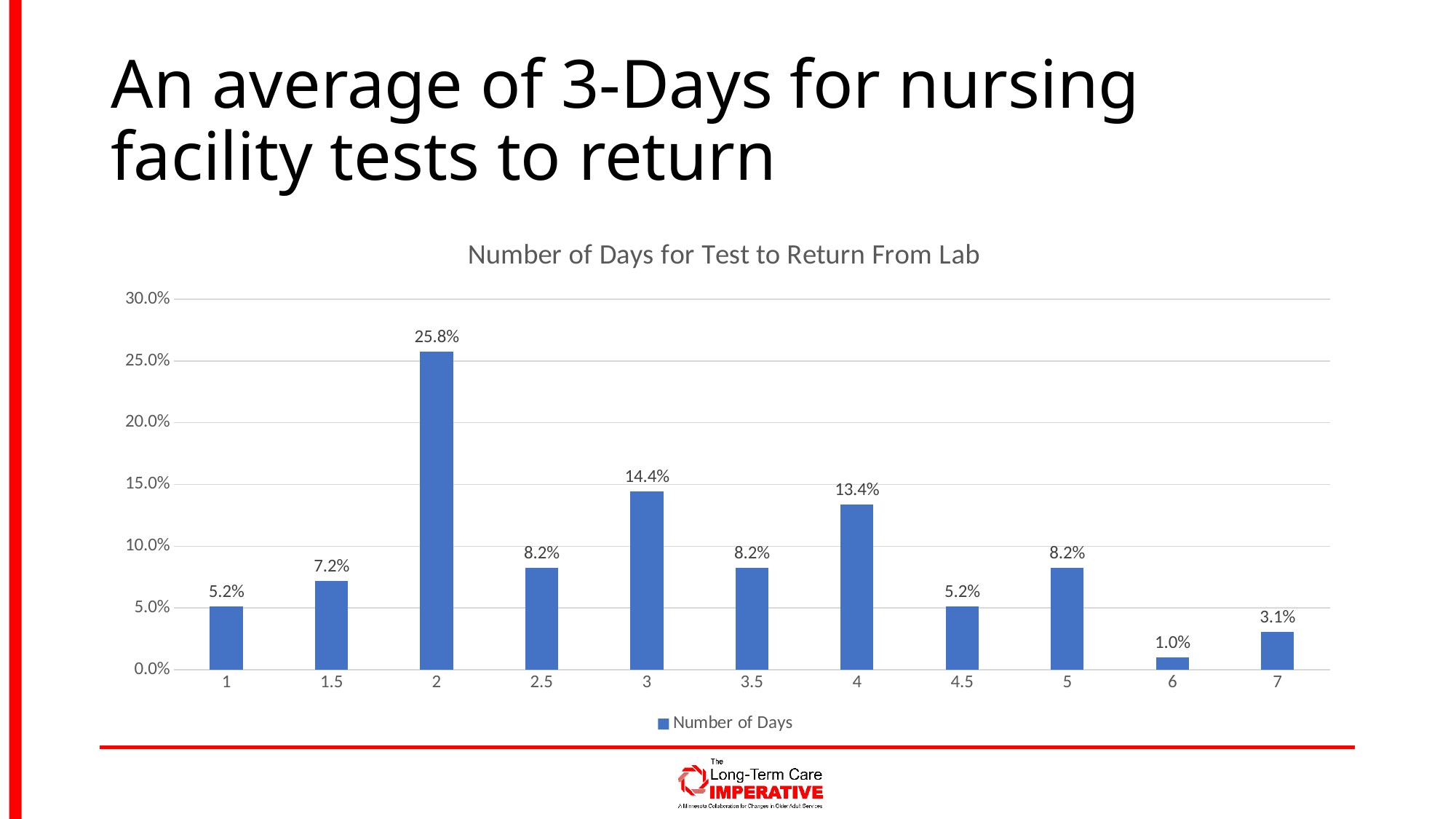
Which category has the lowest value? 6 Which category has the highest value? 2 What is the difference between the values for 3 days and 4 days? 1.0% What is the value for 4 days in the chart? 13.4% Is the value for 2 days greater or less than 20.0%? greater What is the value for 7 days in the chart? 3.1% How many categories are shown on the x axis? 11 What is the value for 2 days in the chart? 25.8% What kind of chart is shown on the slide? Bar chart How many series does the legend list? 1 What is the title of the chart? Number of Days for Test to Return From Lab Which is larger, the value for 1.5 days or the value for 4.5 days? 1.5